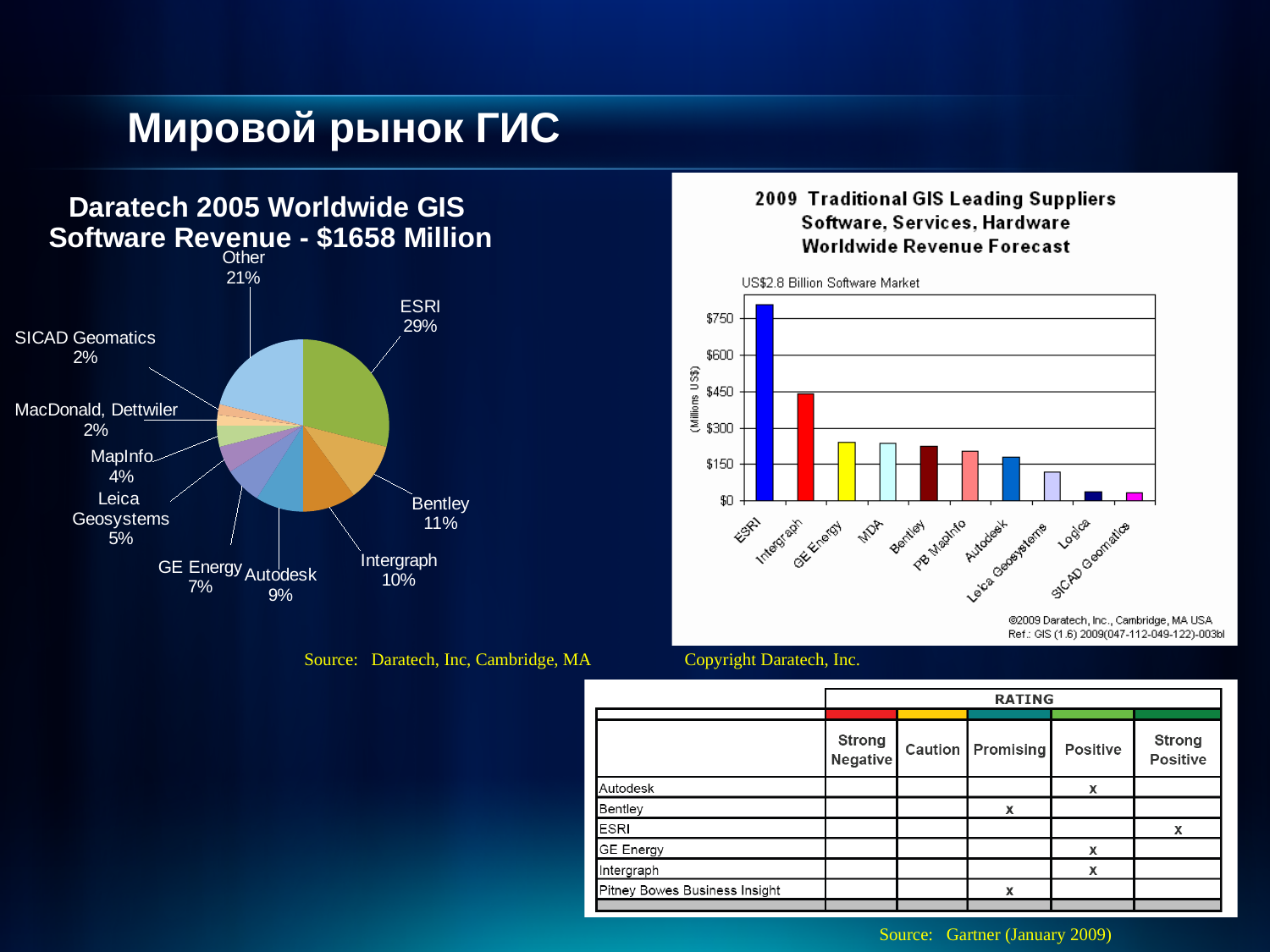
In the '2009 Traditional GIS Leading Suppliers' bar chart, is the value for ESRI greater or less than $750? greater What type of chart is the '2009 Traditional GIS Leading Suppliers' chart on the right? Bar chart In the pie chart 'Daratech 2005 Worldwide GIS Software Revenue', what share does ESRI hold? 29% In the pie chart 'Daratech 2005 Worldwide GIS Software Revenue', what is the difference in percentage points between Intergraph and Autodesk? 1 percentage point In the '2009 Traditional GIS Leading Suppliers' bar chart, which supplier has the highest revenue forecast? ESRI In the '2009 Traditional GIS Leading Suppliers' bar chart, is the value for Leica Geosystems greater or less than $150? less How many slices does the pie chart 'Daratech 2005 Worldwide GIS Software Revenue' have? 10 In the pie chart 'Daratech 2005 Worldwide GIS Software Revenue', what share does Bentley hold? 11% How many suppliers are shown on the x axis of the '2009 Traditional GIS Leading Suppliers' bar chart? 10 In the pie chart 'Daratech 2005 Worldwide GIS Software Revenue', which is larger, the share of GE Energy or the share of Leica Geosystems? GE Energy What type of chart is the 'Daratech 2005 Worldwide GIS Software Revenue' chart? Pie chart In the pie chart 'Daratech 2005 Worldwide GIS Software Revenue', which named vendor has the largest share? ESRI